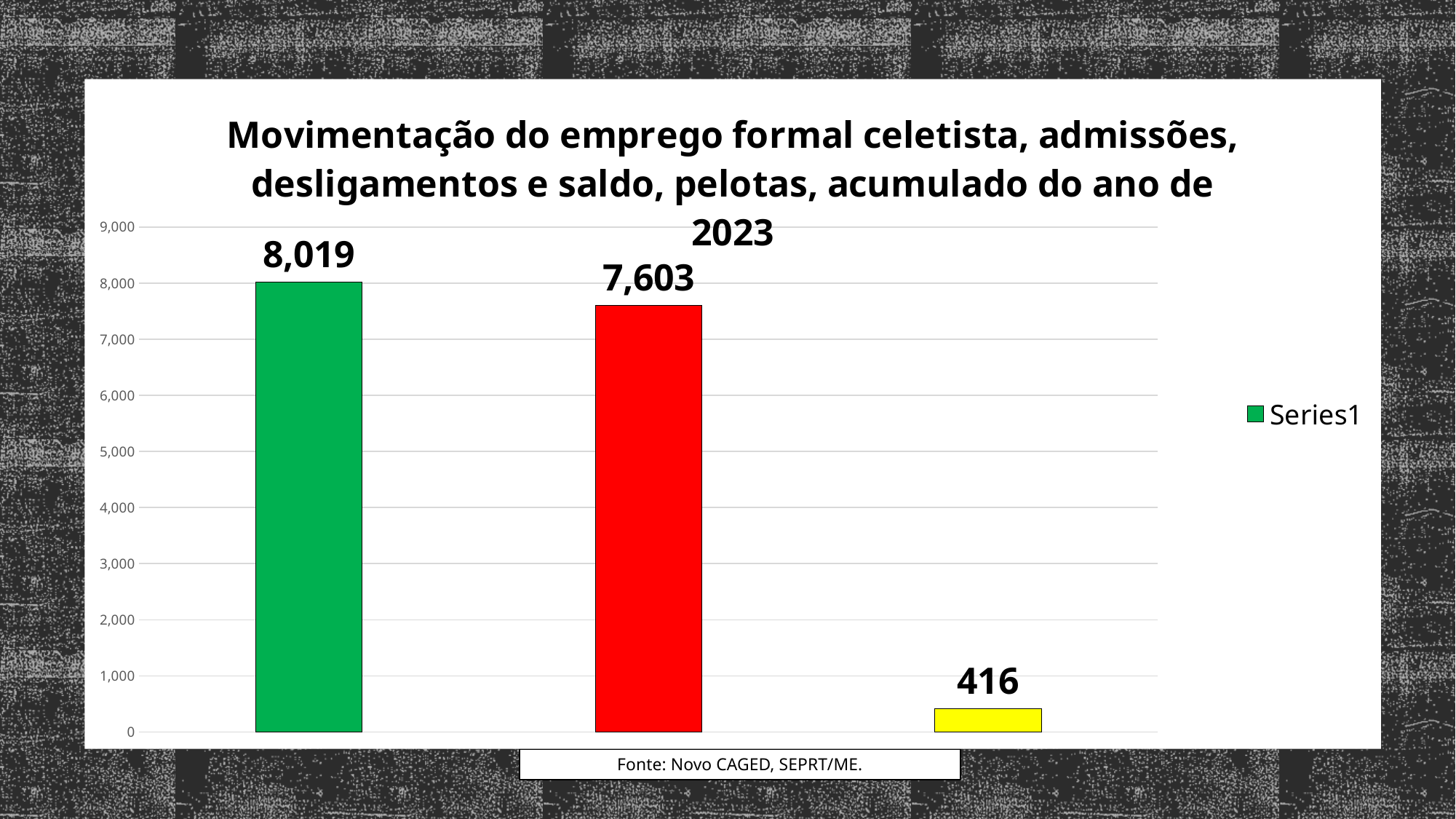
What is the value shown on the yellow bar (the rightmost bar)? 416 Which bar has the highest value: the green, red or yellow one? green How many bars are plotted in the chart? 3 Which is larger, the value of the red bar or the value of the yellow bar? red bar What is the difference between the value of the red bar and the value of the yellow bar? 7,187 How many series does the legend list? 1 What type of chart is shown on the slide? bar chart Is the value of the red bar greater or less than 8,000? less What is the value shown on the red bar (the middle bar)? 7,603 Which bar has the lowest value: the green, red or yellow one? yellow What is the difference between the value of the green bar and the value of the red bar? 416 What is the value shown on the green bar (the first bar from the left)? 8,019